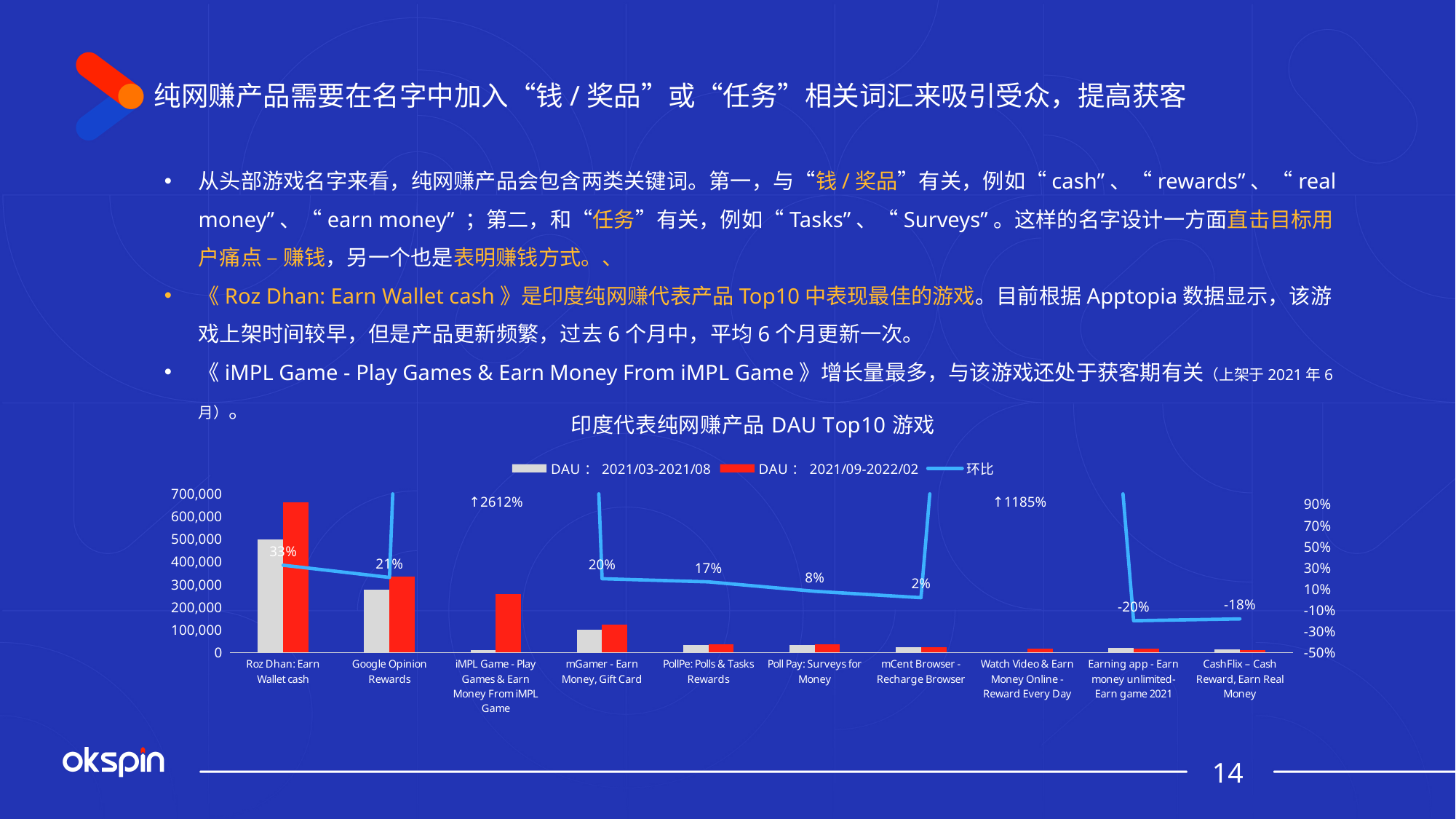
What is the title of the chart? 印度代表纯网赚产品 DAU Top10 游戏 What is the difference between the 环比 values of Roz Dhan: Earn Wallet cash and Google Opinion Rewards? 12 percentage points What kind of chart is shown on the slide? A bar chart with a line series Is the DAU for 2021/09-2022/02 of Roz Dhan: Earn Wallet cash greater or less than 600,000? greater What is the 环比 value for iMPL Game - Play Games & Earn Money From iMPL Game? ↑2612% Which game has the lowest 环比 value? Earning app - Earn money unlimited- Earn game 2021 Which game has the larger DAU for 2021/09-2022/02: Roz Dhan: Earn Wallet cash or Google Opinion Rewards? Roz Dhan: Earn Wallet cash How many games are shown along the x axis? 10 How many series does the legend list? 3 Which game has the highest 环比 value? iMPL Game - Play Games & Earn Money From iMPL Game What is the 环比 value for Roz Dhan: Earn Wallet cash? 33% What is the 环比 value for CashFlix – Cash Reward, Earn Real Money? -18%